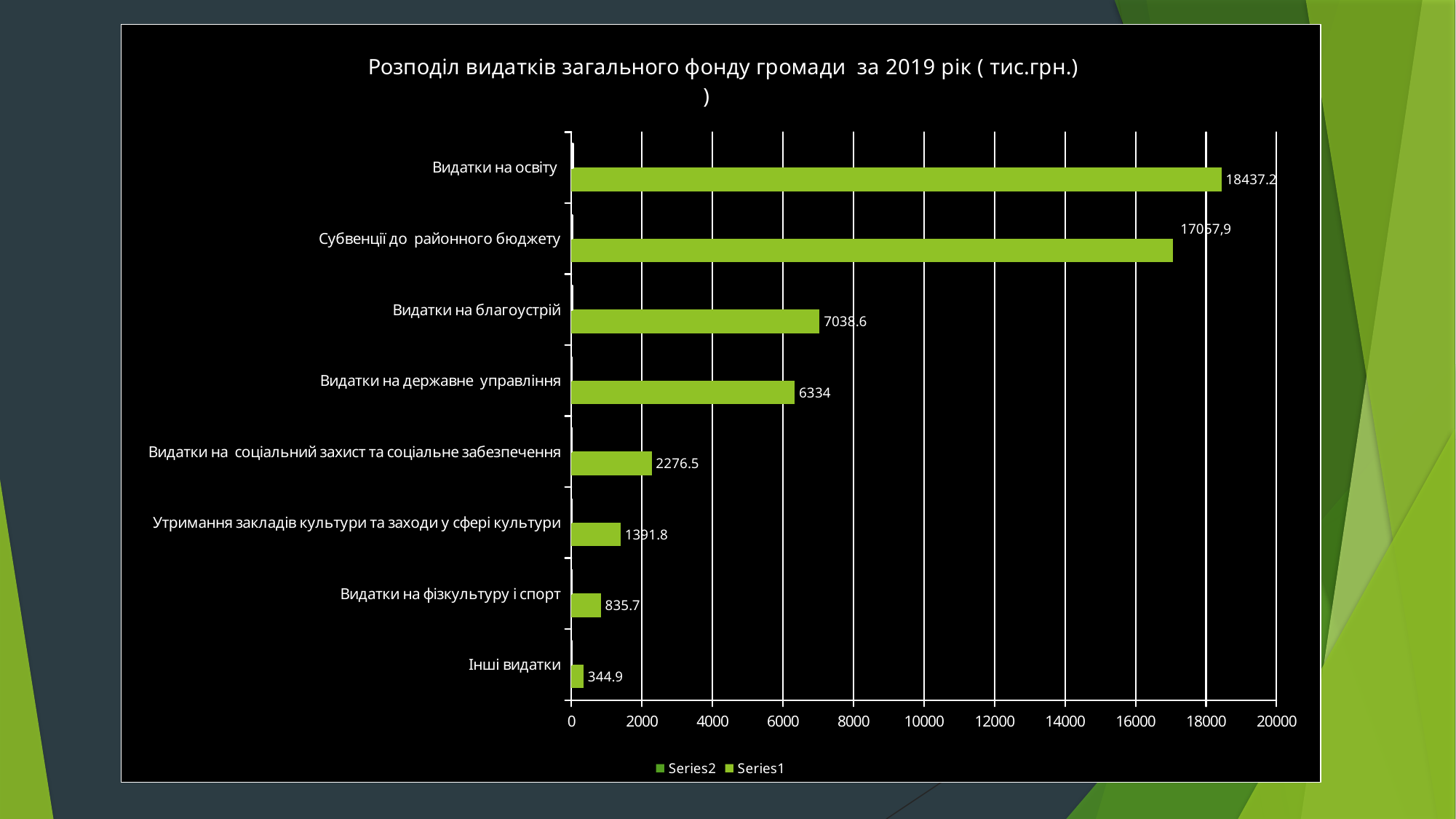
What is the value for Видатки на соціальний захист та соціальне забезпечення? 2276.5 What is the value for Видатки на благоустрій? 7038.6 What is the value for Видатки на фізкультуру і спорт? 835.7 What is the value for Видатки на державне управління? 6334 What is the value for Видатки на освіту? 18437.2 Which is larger: Утримання закладів культури та заходи у сфері культури or Видатки на фізкультуру і спорт? Утримання закладів культури та заходи у сфері культури Is the value for Субвенції до районного бюджету greater or less than 16000? greater Which category has the highest value? Видатки на освіту What type of chart is shown on the slide? bar chart How many categories are shown on the chart? 8 What is the difference between Видатки на благоустрій and Видатки на державне управління? 704.6 Which category has the lowest value? Інші видатки